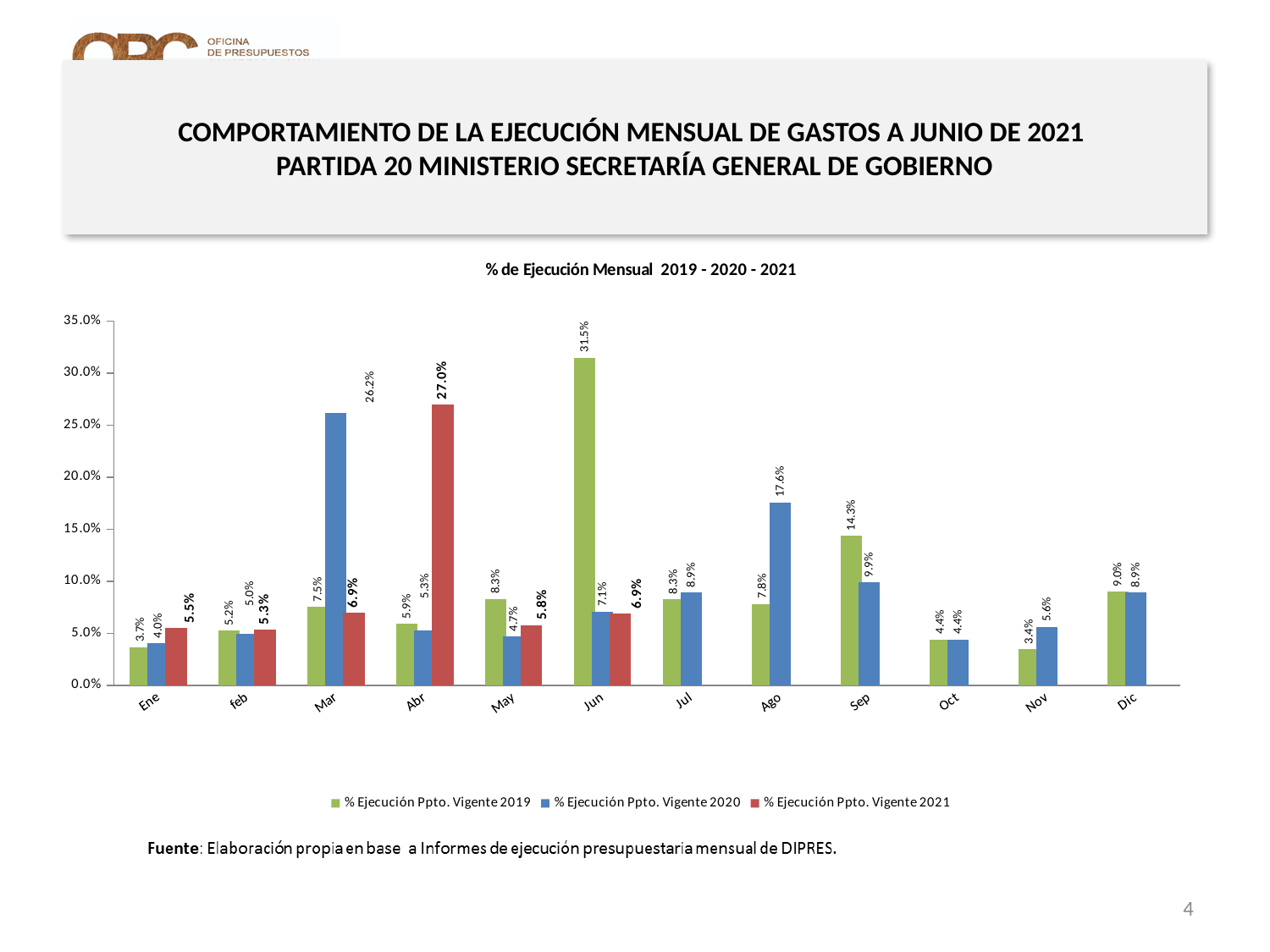
What kind of chart is shown on the slide? Bar chart What is the difference between the 2020 value and the 2019 value in Ago? 9.8% What colour represents % Ejecución Ppto. Vigente 2021 in the chart? Red What is the value for % Ejecución Ppto. Vigente 2021 in Abr? 27.0% In which month is the % Ejecución Ppto. Vigente 2019 series highest? Jun What is the value for % Ejecución Ppto. Vigente 2019 in Sep? 14.3% In which month is the % Ejecución Ppto. Vigente 2019 series lowest? Nov How many months are shown on the x axis? 12 What is the value for % Ejecución Ppto. Vigente 2020 in Mar? 26.2% Is the value for % Ejecución Ppto. Vigente 2020 in Mar greater or less than 25.0%? greater How many series does the legend list? 3 Which is larger in Jun: the 2019 value or the 2020 value? 2019 value